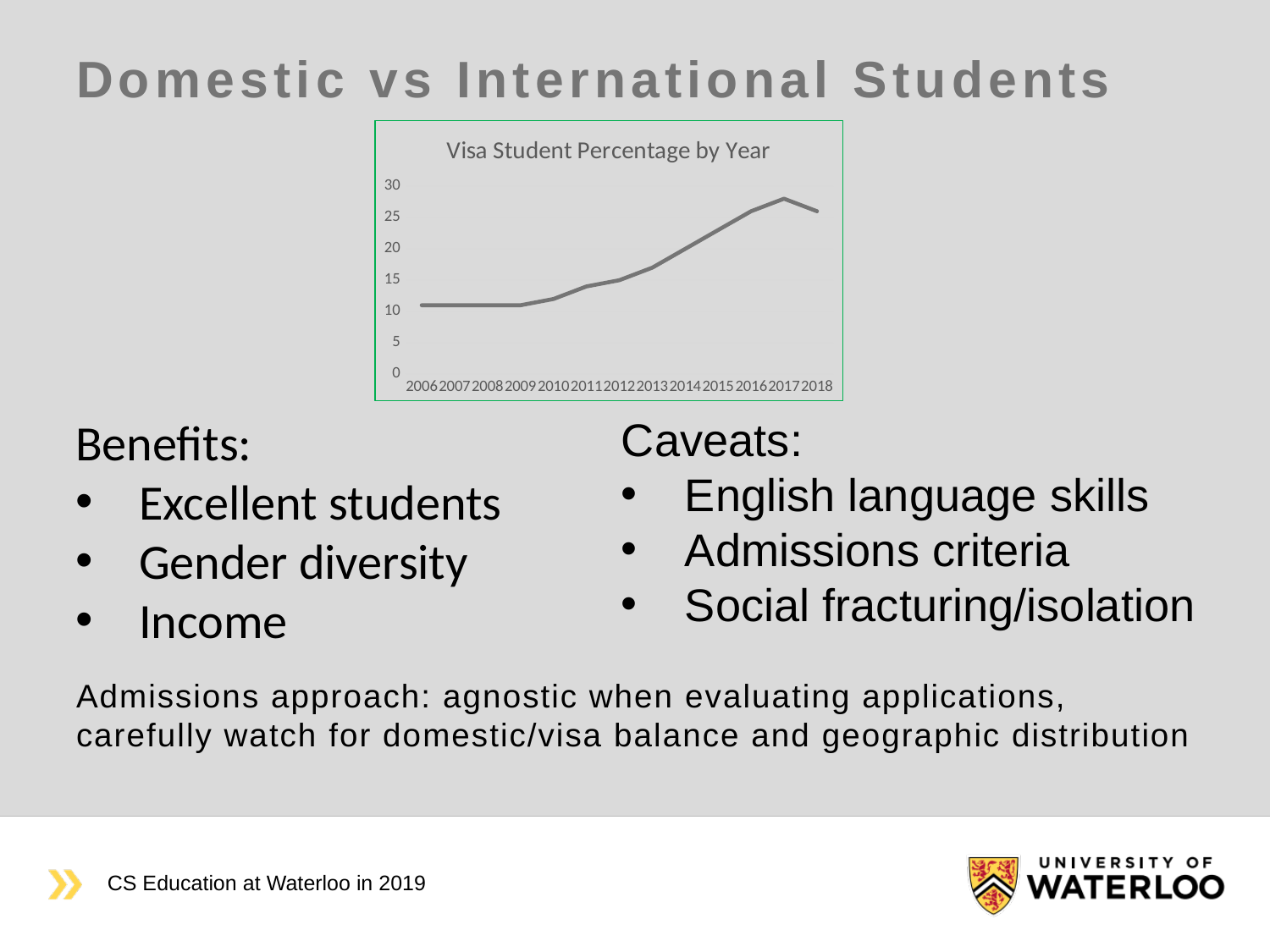
Which year has the larger value, 2006 or 2018? 2018 Is the value for 2014 greater or less than 15? greater Is the value for 2013 greater or less than 20? less Is the value for 2006 greater or less than 15? less Does the visa student percentage generally rise or fall from 2006 to 2017? rise What kind of chart is shown on the slide? line chart What is the title of the chart? Visa Student Percentage by Year Which year has the highest visa student percentage? 2017 Which year has the larger value, 2017 or 2018? 2017 How many years are plotted along the x axis of the chart? 13